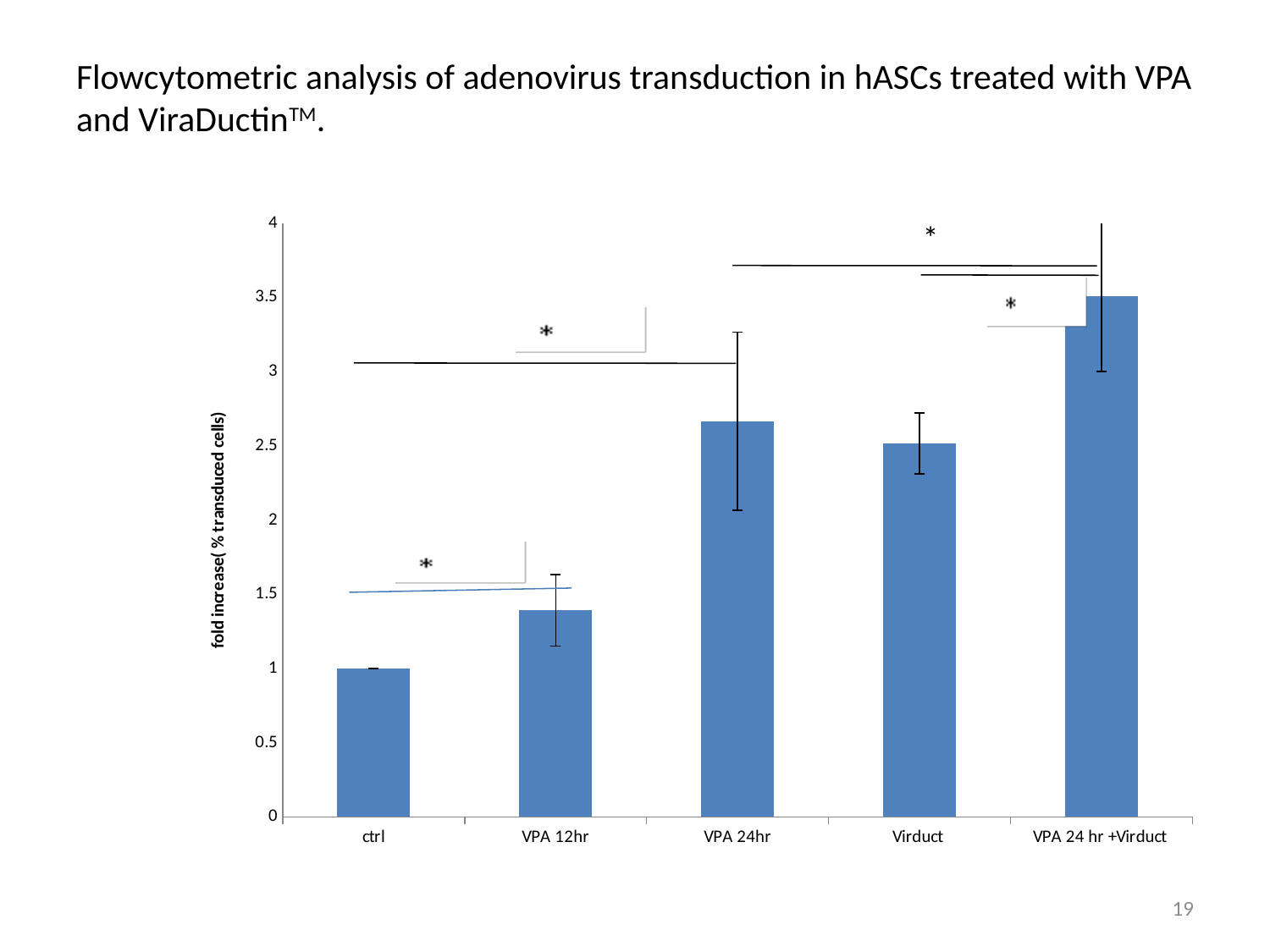
Is the value for VPA 24 hr +Virduct greater or less than 3? greater What kind of chart is shown on the slide? bar chart Is the value for Virduct greater or less than 2? greater Which category has the lowest bar? ctrl Is the value for VPA 24hr greater or less than 2.5? greater Which is larger, the value for VPA 12hr or the value for VPA 24hr? VPA 24hr What is the label of the y axis? fold increase( % transduced cells) What is the value for ctrl? 1 What is the highest value shown on the y axis? 4 Which category has the highest bar? VPA 24 hr +Virduct How many categories are plotted on the x axis? 5